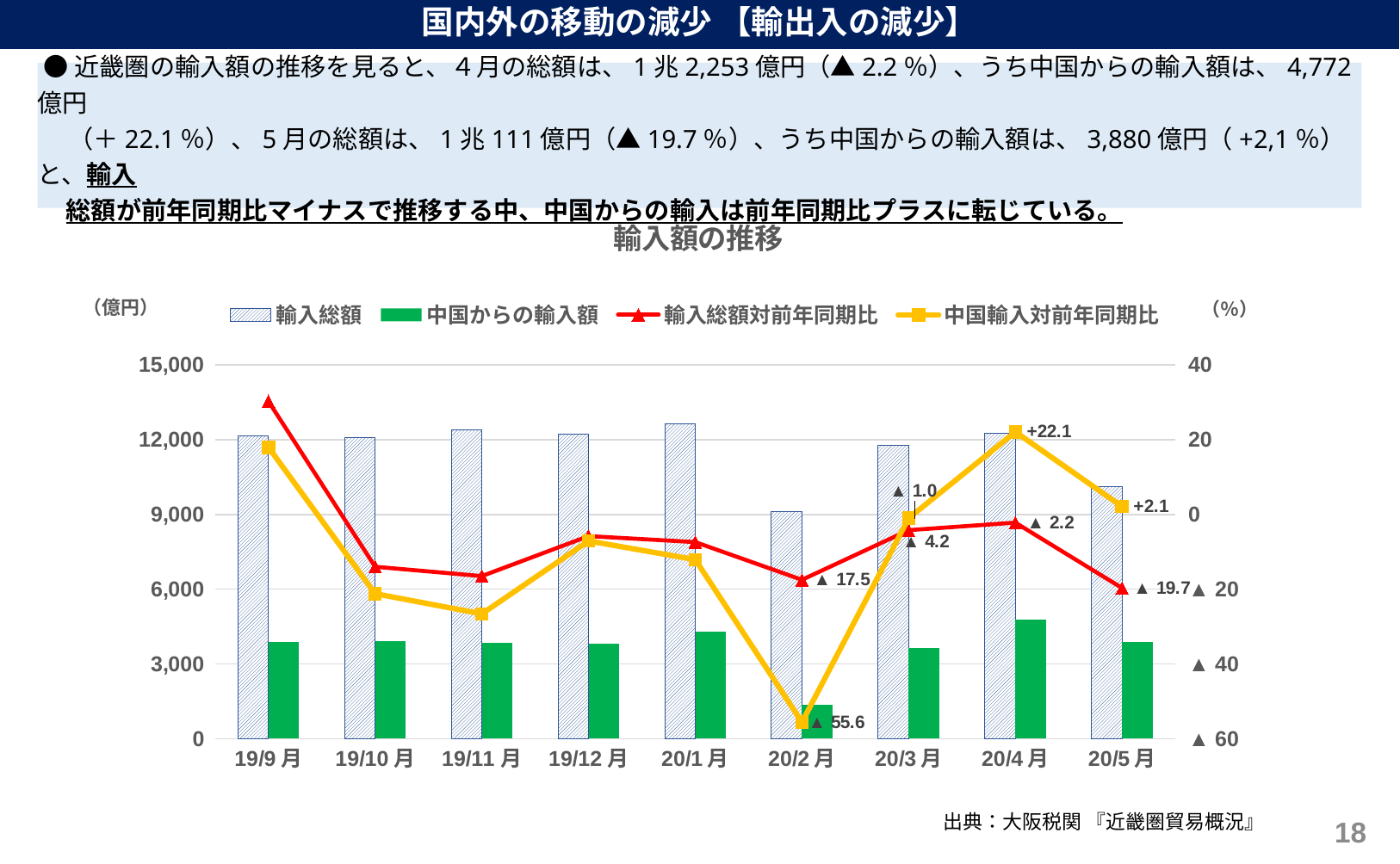
How many months are shown on the x axis of the 輸入額の推移 chart? 9 By how many points does the 中国輸入対前年同期比 value fall from 20/4月 to 20/5月? 20.0 What is the 輸入総額対前年同期比 value for 20/3月? ▲4.2 In which month is the 輸入総額 bar the lowest? 20/2月 In which month is the 中国輸入対前年同期比 line at its lowest? 20/2月 How many series does the legend of the 輸入額の推移 chart list? 4 What is the 輸入総額対前年同期比 value for 20/5月? ▲19.7 At 20/4月, which is higher: 中国輸入対前年同期比 or 輸入総額対前年同期比? 中国輸入対前年同期比 What is the 中国輸入対前年同期比 value for 20/2月? ▲55.6 Is the 中国からの輸入額 value for 20/2月 greater or less than 3,000? less What is the 中国輸入対前年同期比 value for 20/4月? +22.1 What type of chart is shown under the title 輸入額の推移? Combination bar and line chart